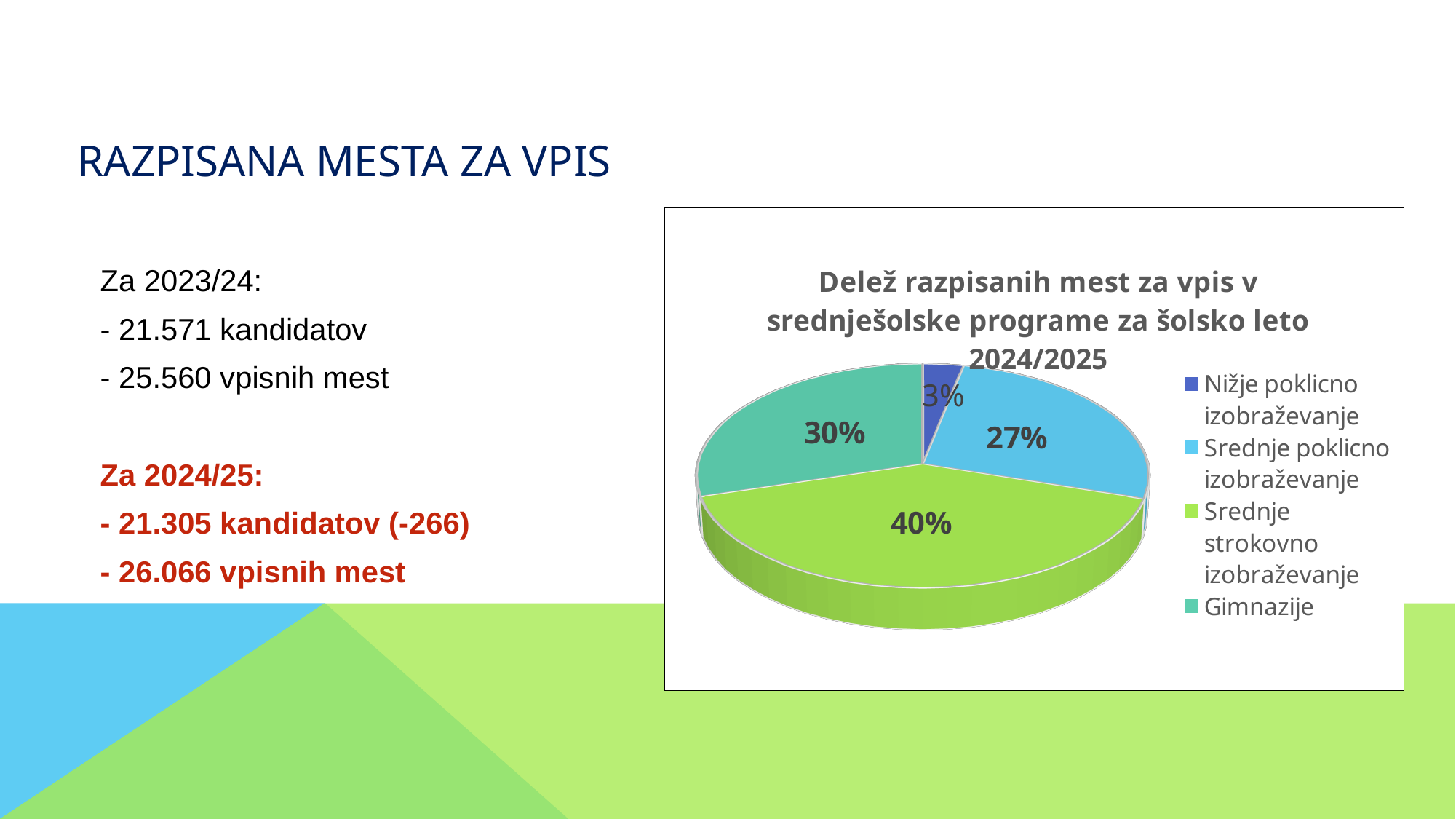
What is the difference in percentage points between the shares of Srednje strokovno izobraževanje and Gimnazije? 10 Which category has the smallest share of the pie? Nižje poklicno izobraževanje How many slices does the pie chart have? 4 Which category has the largest share of the pie? Srednje strokovno izobraževanje What kind of chart is shown on the slide? pie chart Which has a larger share, Gimnazije or Srednje poklicno izobraževanje? Gimnazije Which colour represents Gimnazije in the pie chart? teal What share of the pie does Nižje poklicno izobraževanje have? 3% What share of the pie does Gimnazije have? 30% What share of the pie does Srednje strokovno izobraževanje have? 40% What is the title of the pie chart? Delež razpisanih mest za vpis v srednješolske programe za šolsko leto 2024/2025